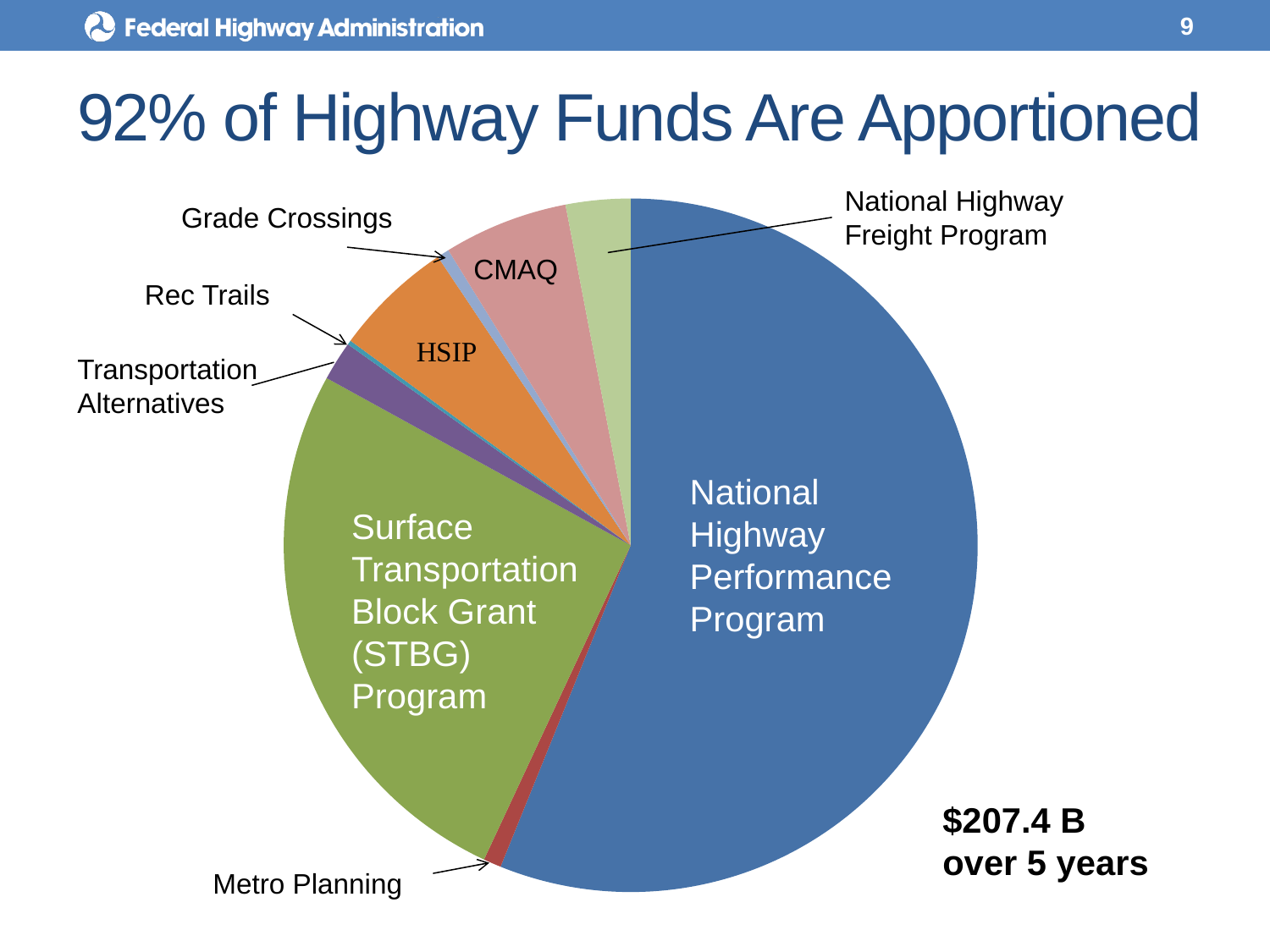
Which slice is larger, Surface Transportation Block Grant (STBG) Program or HSIP? Surface Transportation Block Grant (STBG) Program How many slices does the pie chart have? 9 Which slice is larger, National Highway Freight Program or Grade Crossings? National Highway Freight Program Which slice is larger, HSIP or Transportation Alternatives? HSIP What kind of chart is shown on the slide? pie chart What is the title of the slide containing the pie chart? 92% of Highway Funds Are Apportioned What total funding amount is stated next to the pie chart? $207.4 B over 5 years Which program has the largest slice of the pie chart? National Highway Performance Program